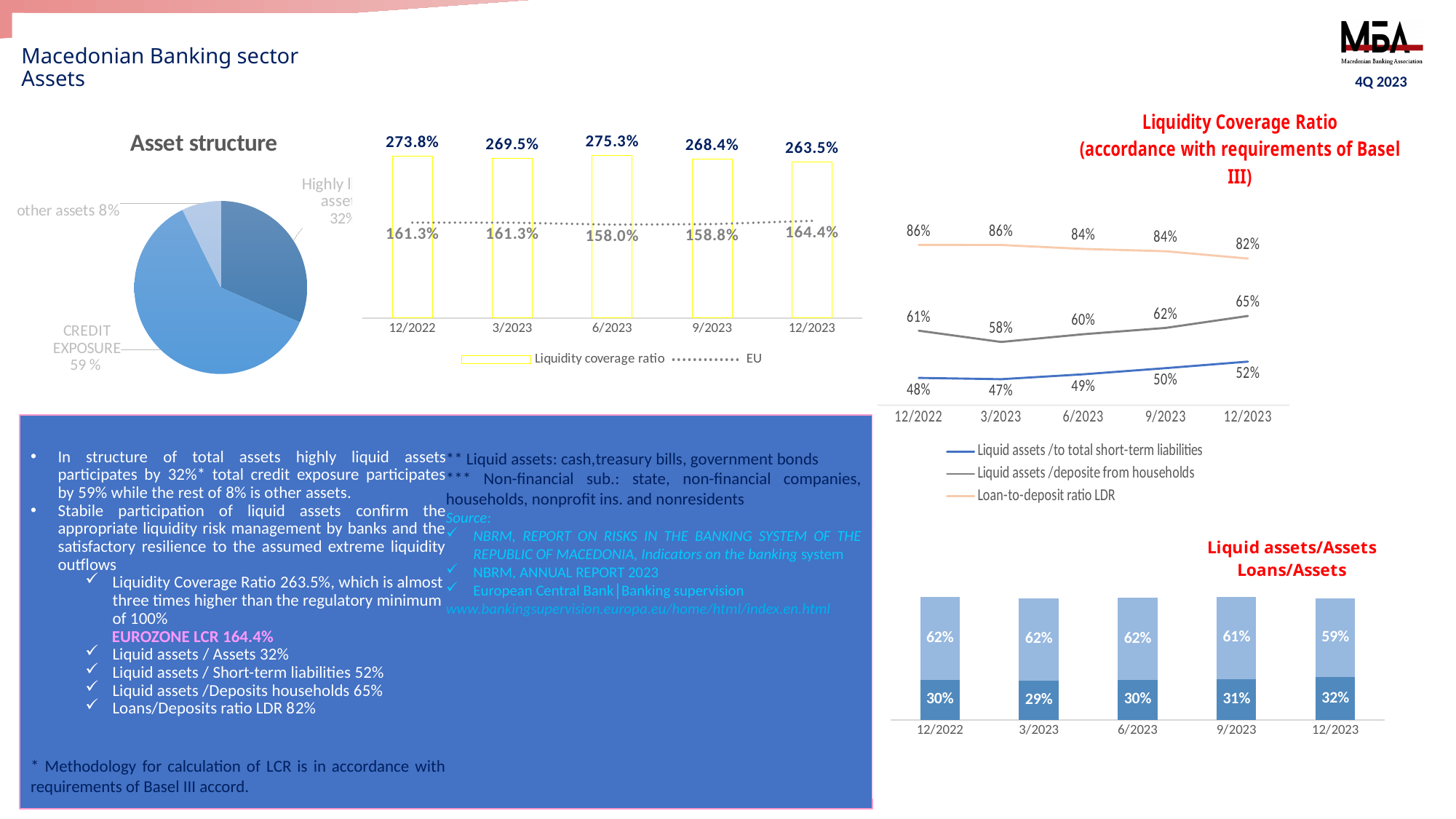
In the Liquidity Coverage Ratio (Basel III) line chart, does the Loan-to-deposit ratio LDR rise or fall from 12/2022 to 12/2023? fall In the Liquidity coverage ratio chart (middle top), which period has the lowest Liquidity coverage ratio? 12/2023 In the Liquidity coverage ratio chart (middle top), what is the difference between the Liquidity coverage ratio and the EU value for 12/2022? 112.5 percentage points In the Liquidity Coverage Ratio (Basel III) line chart, what is the Loan-to-deposit ratio LDR for 12/2023? 82% In the Liquidity Coverage Ratio (Basel III) line chart, which period has the lowest value for Liquid assets /deposite from households? 3/2023 In the Asset structure pie chart, what share is other assets? 8% In the Liquid assets/Assets Loans/Assets chart, what is the total of the stacked bar for 12/2023? 91% In the Asset structure pie chart, what share is credit exposure? 59 % In the Liquidity coverage ratio chart (middle top), what is the Liquidity coverage ratio for 6/2023? 275.3% In the Liquidity Coverage Ratio (Basel III) line chart, how many series does the legend list? 3 In the Liquidity coverage ratio chart (middle top), what is the EU value for 12/2023? 164.4% In the Liquid assets/Assets Loans/Assets chart, how many periods are shown on the x axis? 5